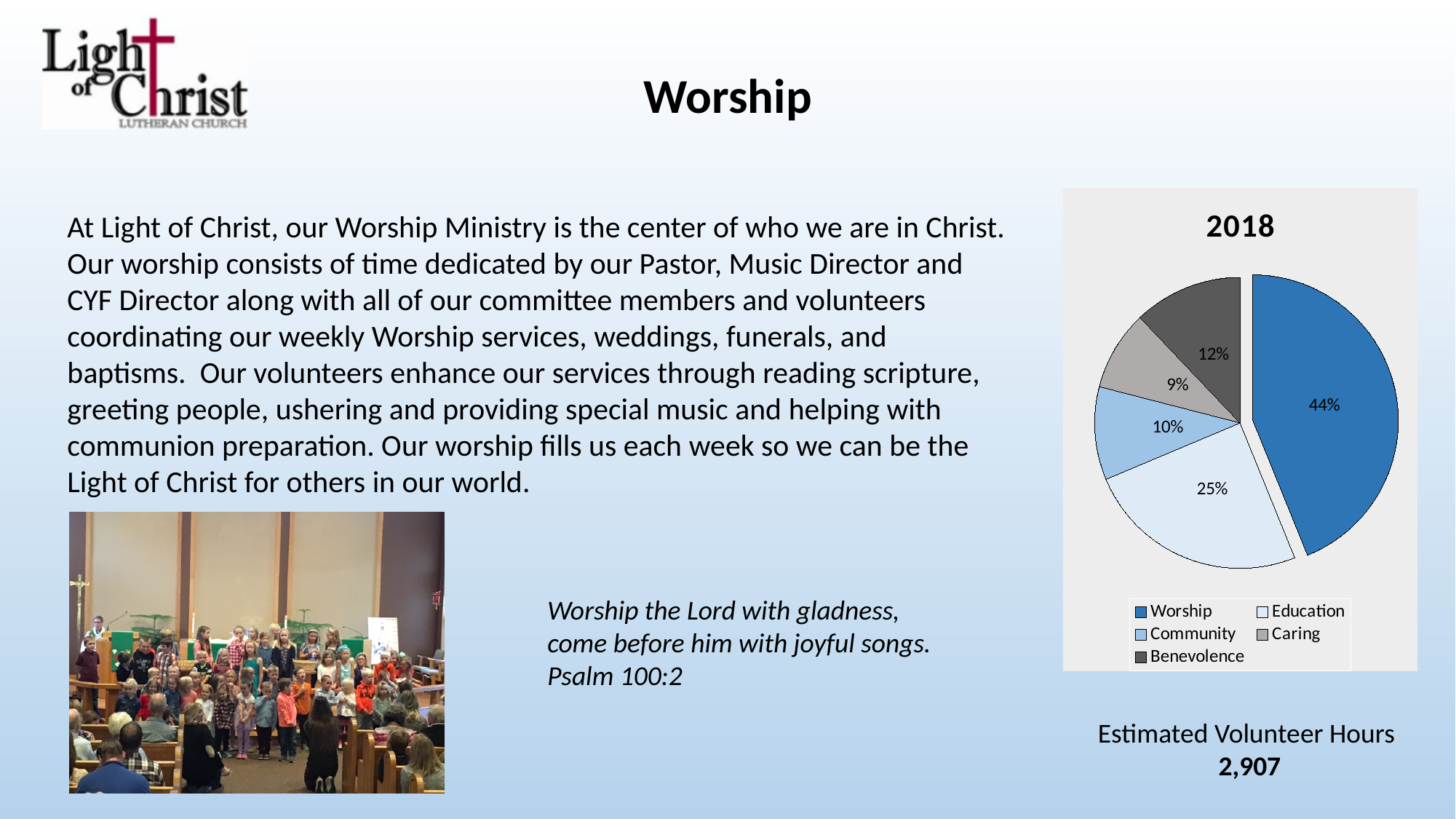
What share of the pie does Community have? 10% What share of the pie does Caring have? 9% Which is larger, the Benevolence slice or the Community slice? Benevolence What share of the pie does Education have? 25% What is the title of the chart? 2018 What kind of chart is shown on the slide? pie chart How many categories does the legend list? 5 What share of the pie does Benevolence have? 12% Which category has the smallest slice of the pie? Caring Which category has the largest slice of the pie? Worship What is the difference in percentage points between Worship and Education? 19 What share of the pie does Worship have? 44%